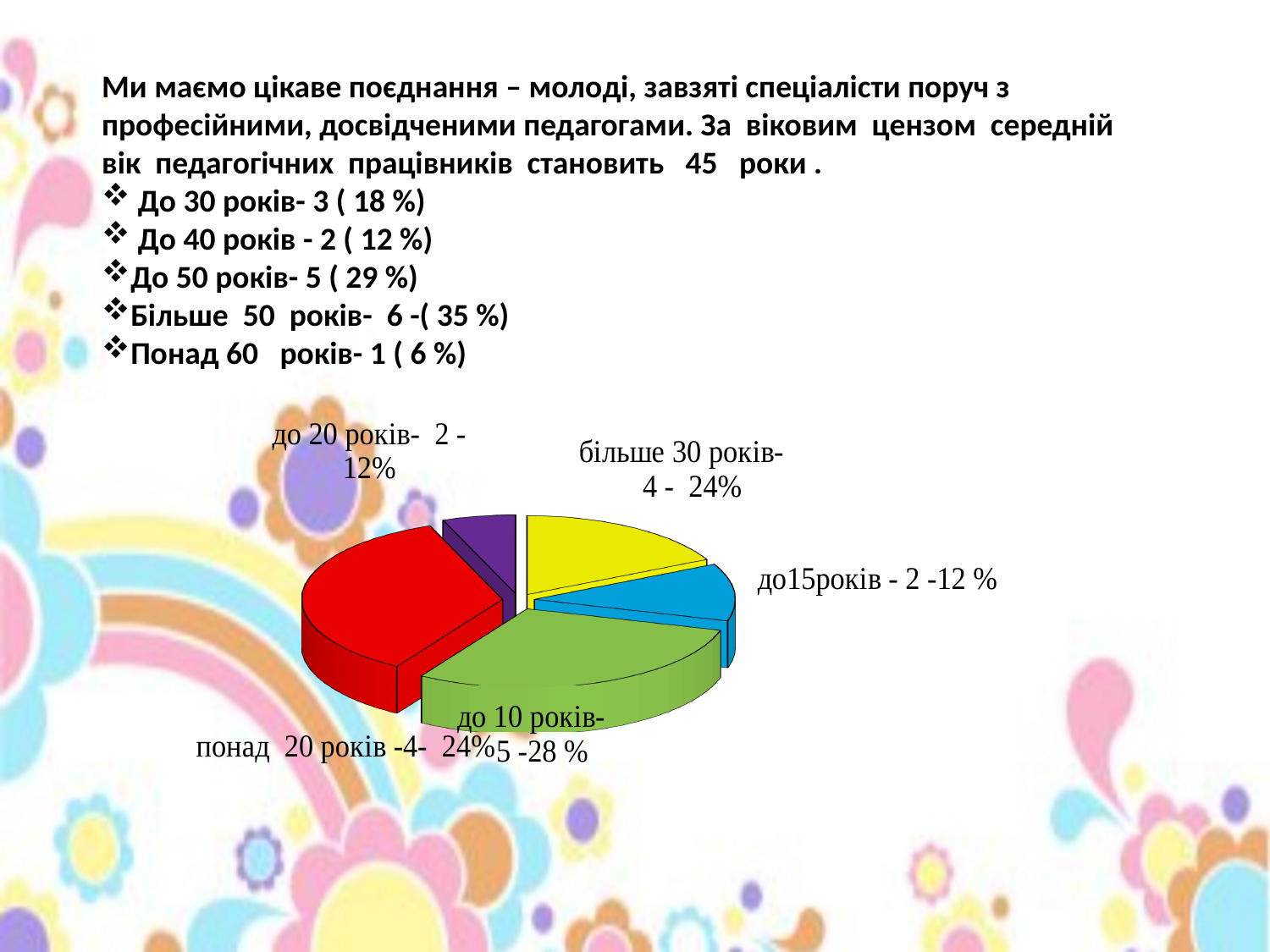
How many people does the pie chart show for "більше 30 років"? 4 What percentage does the pie chart show for "до15років"? 12 % Which is larger in the pie chart: the share for "до 10 років" or the share for "до15років"? до 10 років What percentage does the pie chart show for "до 10 років"? 28 % What kind of chart is shown on the slide? pie chart Which category does the red slice of the pie chart represent? понад 20 років How many more people are in "до 10 років" than in "до 20 років"? 3 How many slices does the pie chart have? 5 What is the difference in percentage points between "до 10 років" (28 %) and "понад 20 років" (24%)? 4 How many people does the pie chart show for "понад 20 років"? 4 What percentage does the pie chart show for "до 20 років"? 12%